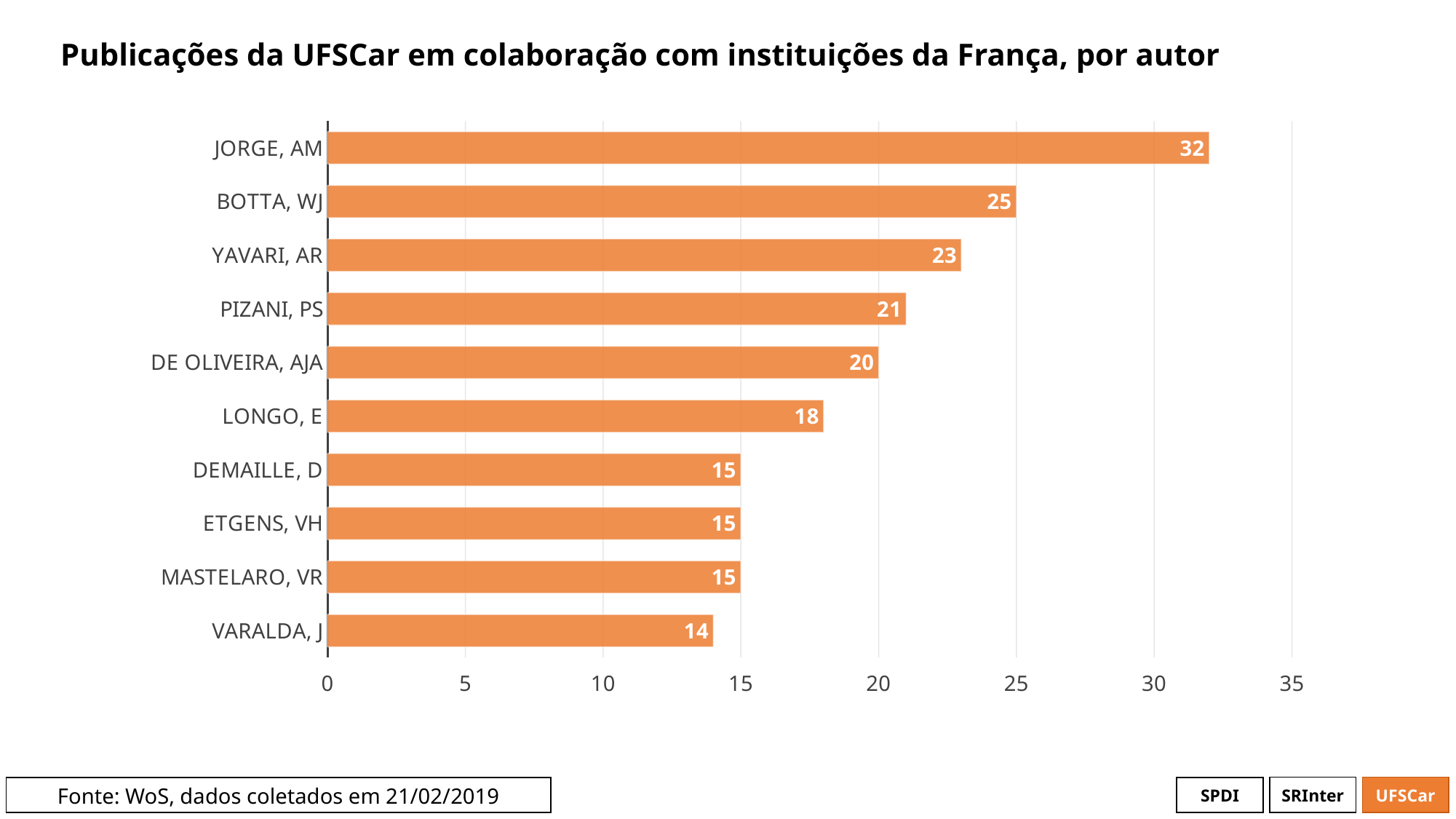
What kind of chart is shown on the slide? Bar chart How many authors are shown in the chart? 10 Which author has the highest number of publications? JORGE, AM Which author has the lowest number of publications? VARALDA, J Is the value for BOTTA, WJ greater or less than 20? greater How many publications does JORGE, AM have? 32 Which has a larger value, PIZANI, PS or LONGO, E? PIZANI, PS What is the value shown for VARALDA, J? 14 What is the difference between the values for YAVARI, AR and LONGO, E? 5 What is the value shown for DE OLIVEIRA, AJA? 20 What is the difference between the values for JORGE, AM and BOTTA, WJ? 7 What is the title of the chart? Publicações da UFSCar em colaboração com instituições da França, por autor